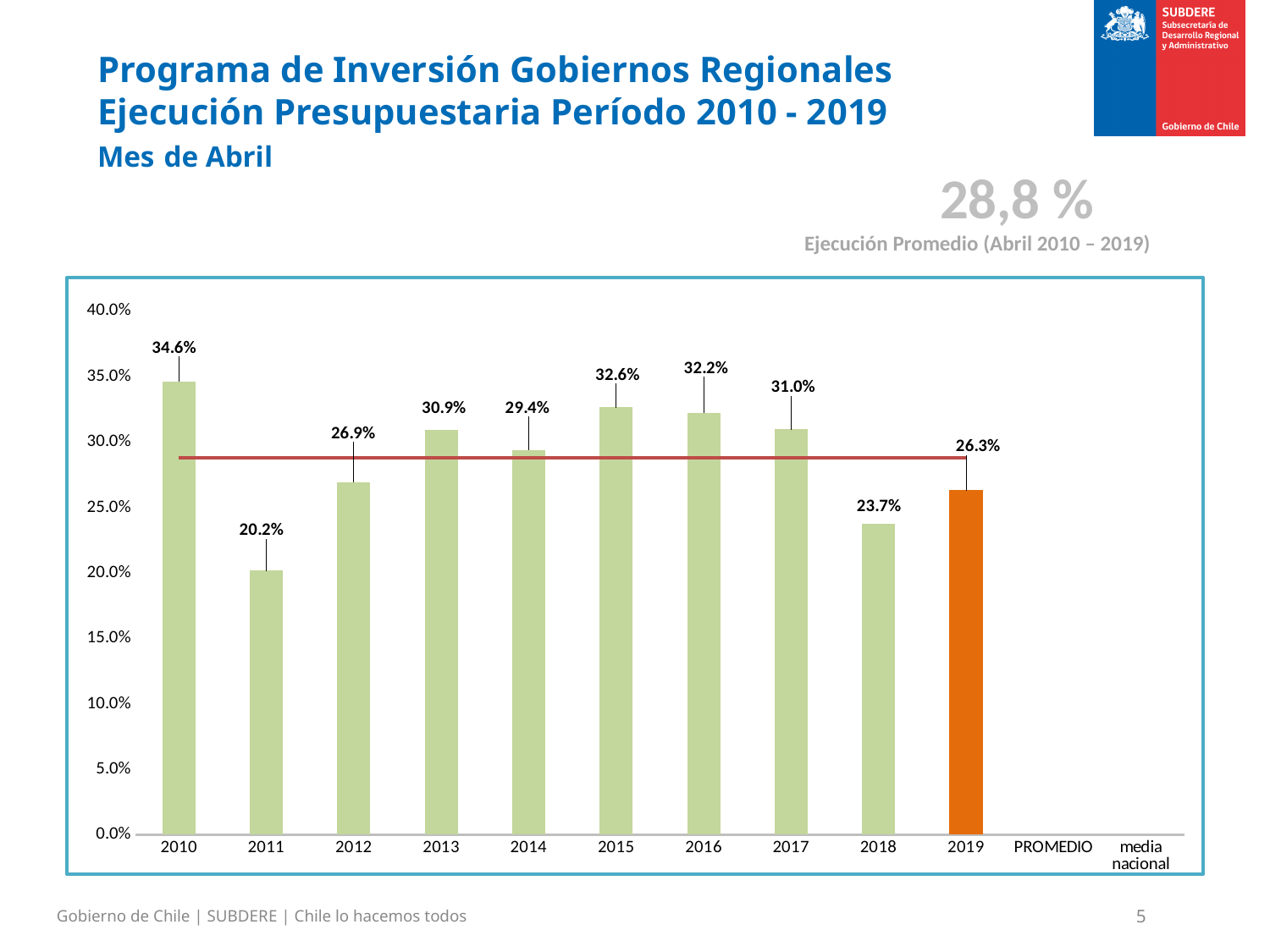
What is the difference between the values for 2010 and 2011? 14.4% What is the difference between the values for 2018 and 2019? 2.6% Is the value for 2017 greater or less than 30.0%? greater Which year has the lowest value? 2011 What is the value for 2010? 34.6% What is the value for 2015? 32.6% How many years have bars plotted in the chart? 10 Which is larger, the value for 2013 or the value for 2014? 2013 What average execution value is shown above the chart for April 2010 – 2019? 28,8 % Which year has the highest value? 2010 What is the value for 2019? 26.3% What kind of chart is shown on the slide? bar chart